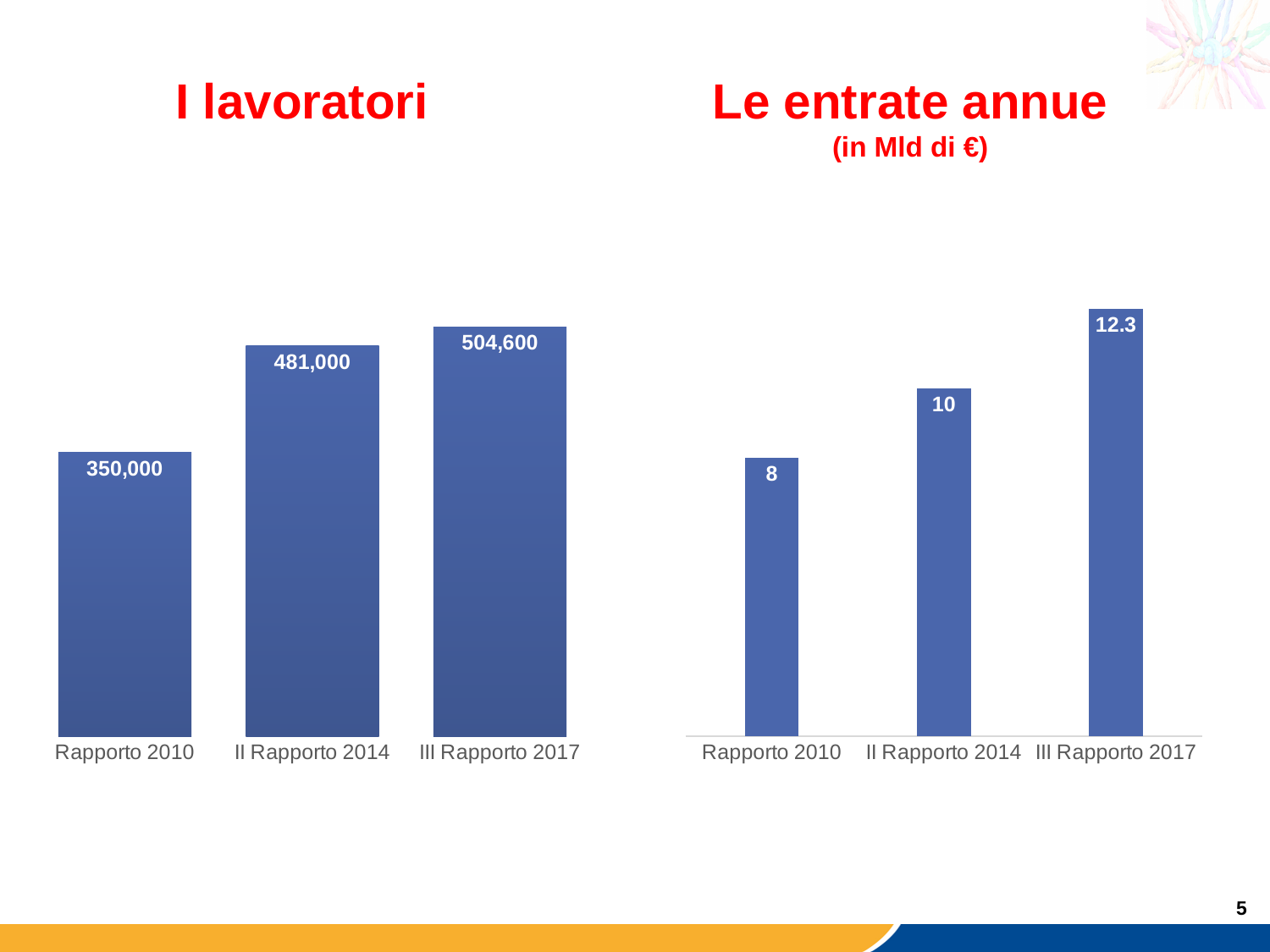
In the 'I lavoratori' chart, what is the value for II Rapporto 2014? 481,000 What kind of chart is the 'I lavoratori' chart? Bar chart In the 'I lavoratori' chart, which is larger: Rapporto 2010 or II Rapporto 2014? II Rapporto 2014 In the 'Le entrate annue' chart, do the values rise or fall from Rapporto 2010 to III Rapporto 2017? Rise How many bars are in the 'Le entrate annue' chart? 3 In the 'Le entrate annue' chart, which category has the lowest value? Rapporto 2010 In the 'Le entrate annue' chart, what is the difference between III Rapporto 2017 and II Rapporto 2014? 2.3 In the 'Le entrate annue' chart, what is the value for Rapporto 2010? 8 In the 'Le entrate annue' chart, what is the value for III Rapporto 2017? 12.3 In the 'I lavoratori' chart, what is the value for Rapporto 2010? 350,000 In the 'I lavoratori' chart, what is the difference between III Rapporto 2017 and II Rapporto 2014? 23,600 In the 'I lavoratori' chart, which category has the highest value? III Rapporto 2017